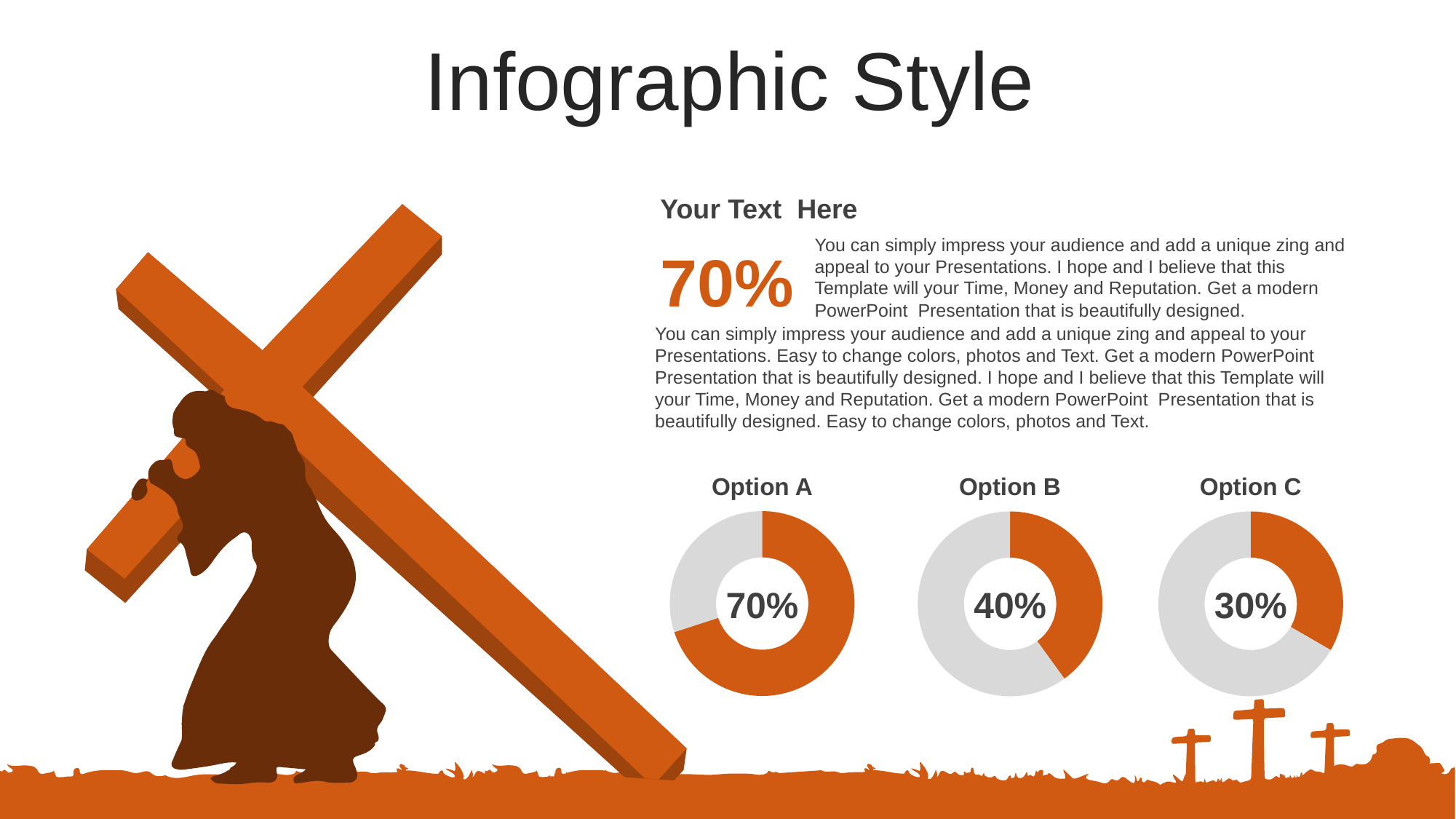
What colour is the filled portion of each doughnut chart? Orange What percentage is shown in the centre of the Option A doughnut chart? 70% What percentage is shown in the centre of the Option B doughnut chart? 40% What is the difference between the percentages shown for Option B and Option C? 10% What is the difference between the percentages shown for Option A and Option B? 30% How many doughnut charts are shown on the slide? 3 Which option has the highest percentage among the three doughnut charts? Option A What percentage is shown in the centre of the Option C doughnut chart? 30% What is the title of the slide? Infographic Style Which is larger, the percentage for Option B or the percentage for Option C? Option B Which option has the lowest percentage among the three doughnut charts? Option C What kind of chart is used to show the Option A, B and C values? Doughnut chart